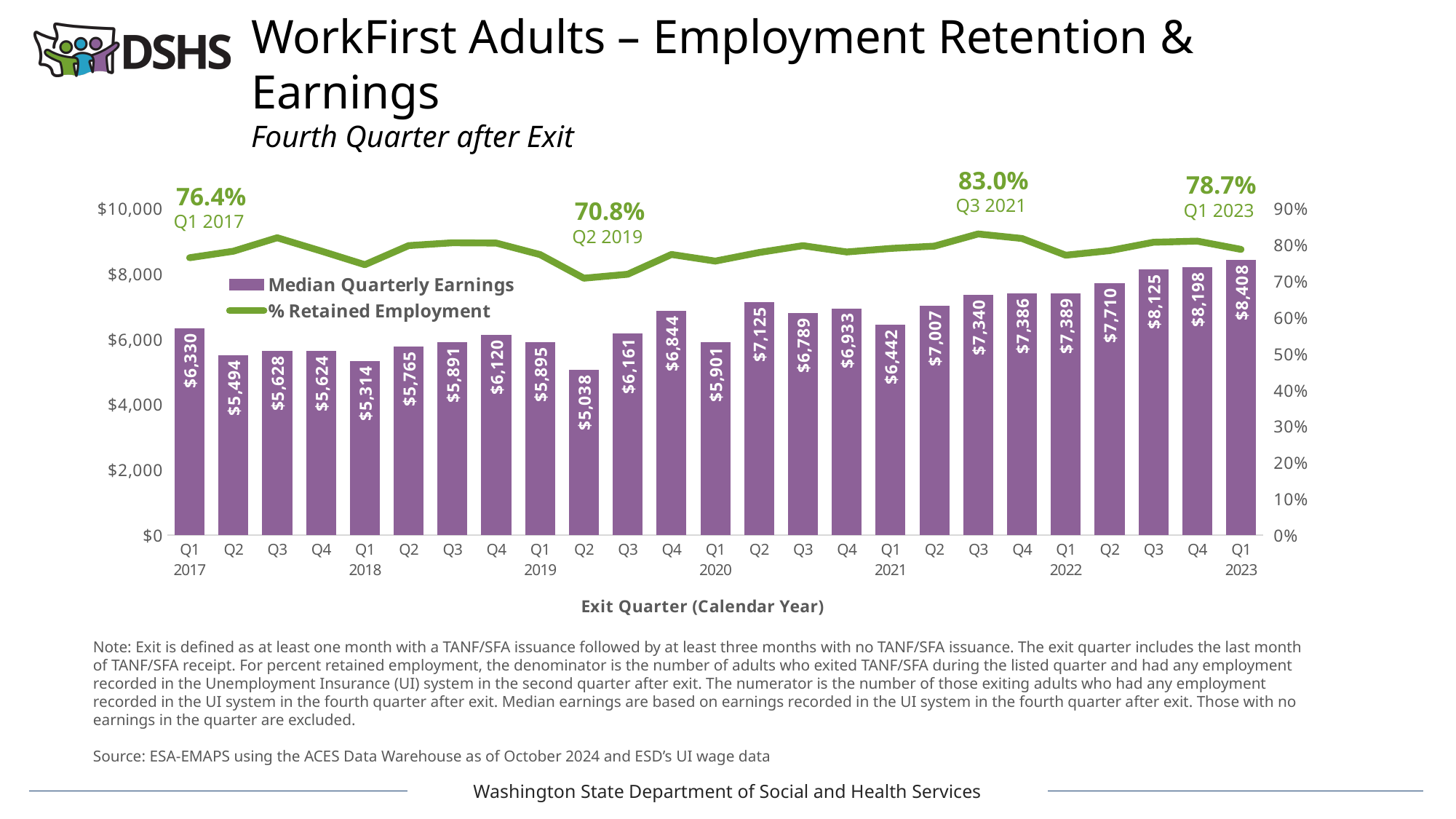
Which exit quarter has the highest median quarterly earnings? Q1 2023 How many exit quarters are shown on the x axis? 25 What kind of chart is this? Combined bar and line chart What is the difference in median quarterly earnings between Q1 2023 and Q1 2017? $2,078 Is the percent retained employment for Q1 2018 greater or less than 80%? less What percent retained employment is labeled for Q1 2017? 76.4% Which has higher median quarterly earnings, Q4 2019 or Q2 2020? Q2 2020 What percent retained employment is labeled for Q3 2021? 83.0% How many series does the legend list? 2 Which exit quarter has the lowest median quarterly earnings? Q2 2019 What is the median quarterly earnings value for Q1 2023? $8,408 What is the median quarterly earnings value for Q2 2019? $5,038